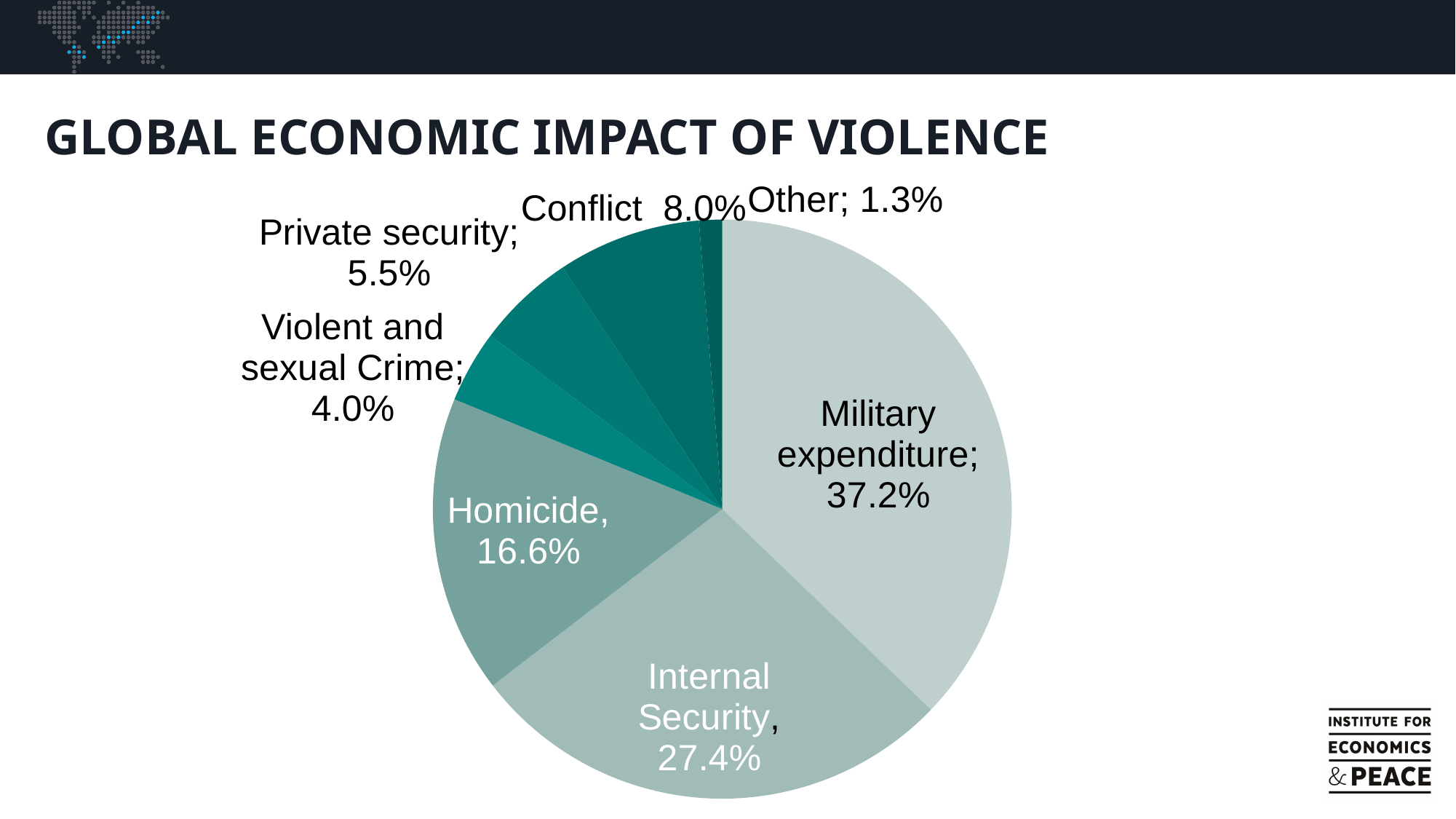
What is the difference between the Military expenditure and Internal Security shares? 9.8% What share is shown for Private security? 5.5% Which category has the largest slice of the pie? Military expenditure Which is larger, the Homicide slice or the Conflict slice? Homicide What is the title of the slide? GLOBAL ECONOMIC IMPACT OF VIOLENCE How many categories are shown in the pie chart? 7 What is the value for Conflict? 8.0% What percentage is labelled for Homicide? 16.6% What share of the pie does Military expenditure account for? 37.2% What is the value shown for Internal Security? 27.4% What type of chart is shown on the slide? Pie chart Which category has the smallest slice of the pie? Other